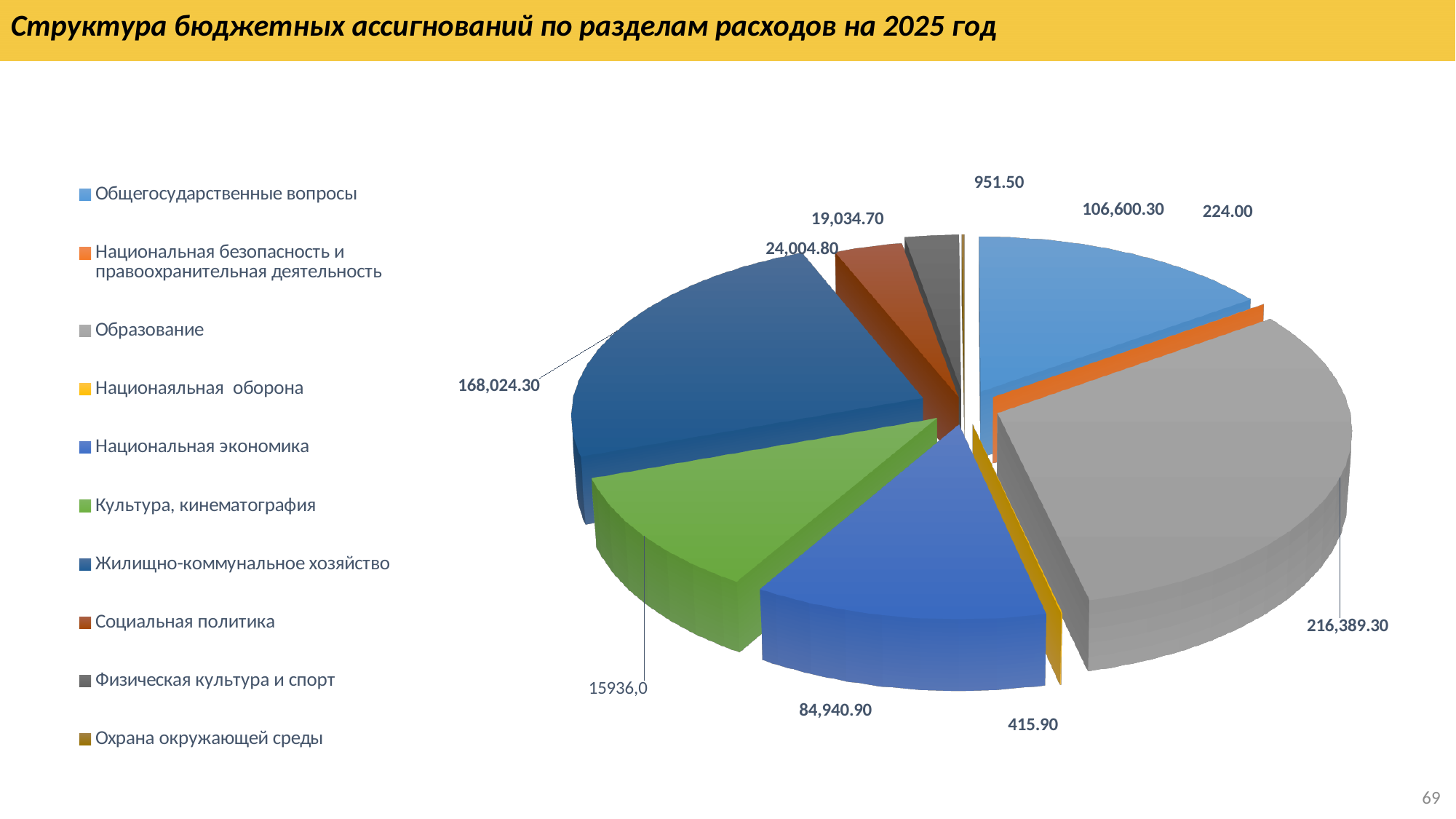
How many categories does the legend list? 10 What is the value for Общегосударственные вопросы? 106,600.30 What type of chart is shown on the slide? Pie chart What is the difference between the values for Образование and Жилищно-коммунальное хозяйство? 48,365.00 Which category has the smallest value? Национальная безопасность и правоохранительная деятельность Which is larger: Социальная политика or Физическая культура и спорт? Социальная политика What is the value for Жилищно-коммунальное хозяйство? 168,024.30 What is the value for Социальная политика? 24,004.80 Which category has the largest value? Образование What is the value for Образование? 216,389.30 What is the value for Национальная экономика? 84,940.90 What is the value for Охрана окружающей среды? 951.50